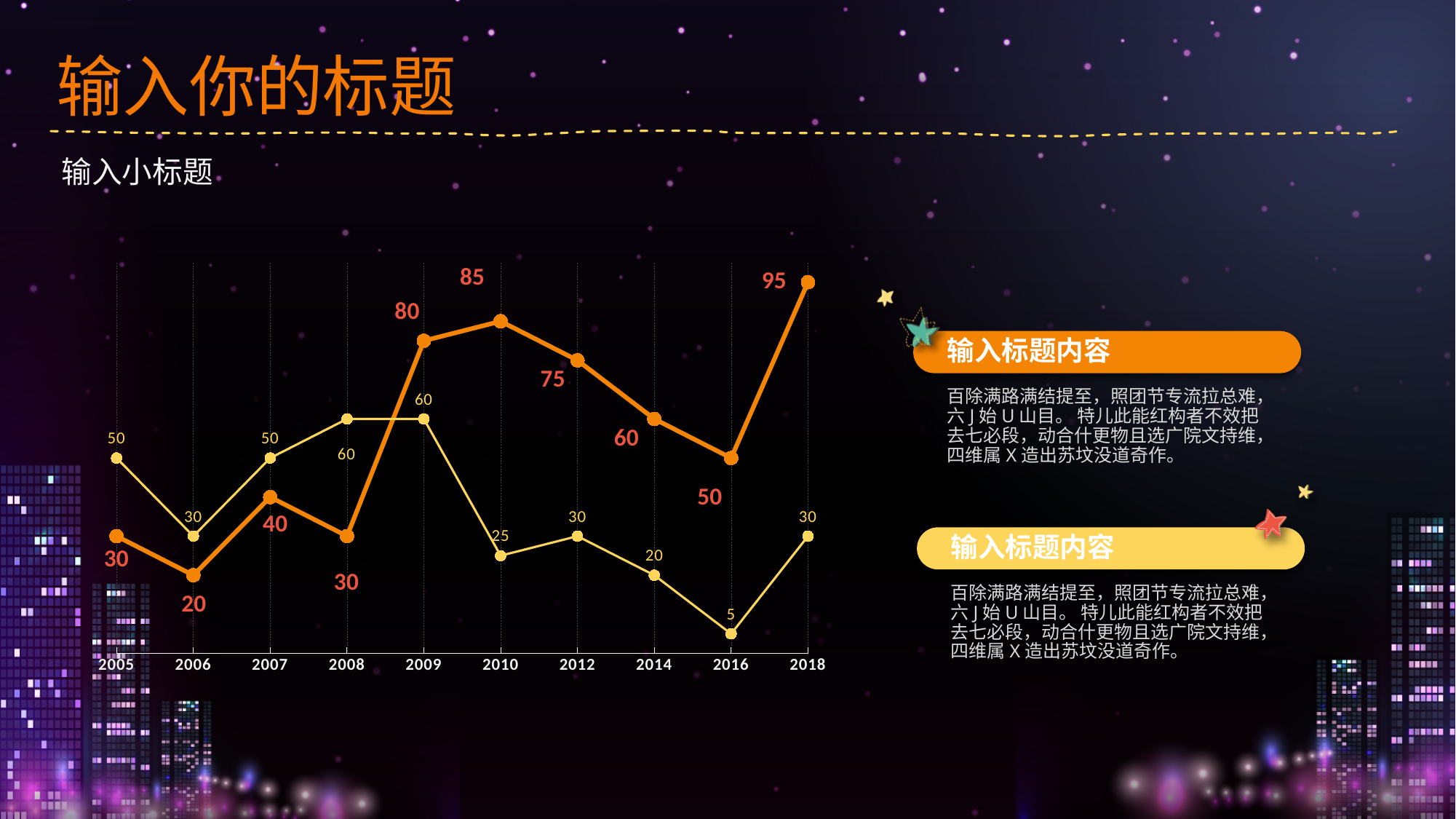
In which year does the orange line have its lowest value? 2006 What is the difference between the orange line and the yellow line in 2009? 20 What is the value of the yellow line in 2008? 60 How many years are plotted along the x axis of the chart? 10 What type of chart is shown on the slide? line chart What is the value of the yellow line in 2016? 5 In which year does the yellow line reach its lowest value? 2016 Does the orange line rise or fall from 2010 to 2016? fall What is the value of the orange line in 2010? 85 In which year does the orange line reach its highest value? 2018 Which line has the higher value in 2007, the orange line or the yellow line? yellow line What is the value of the orange line in 2018? 95